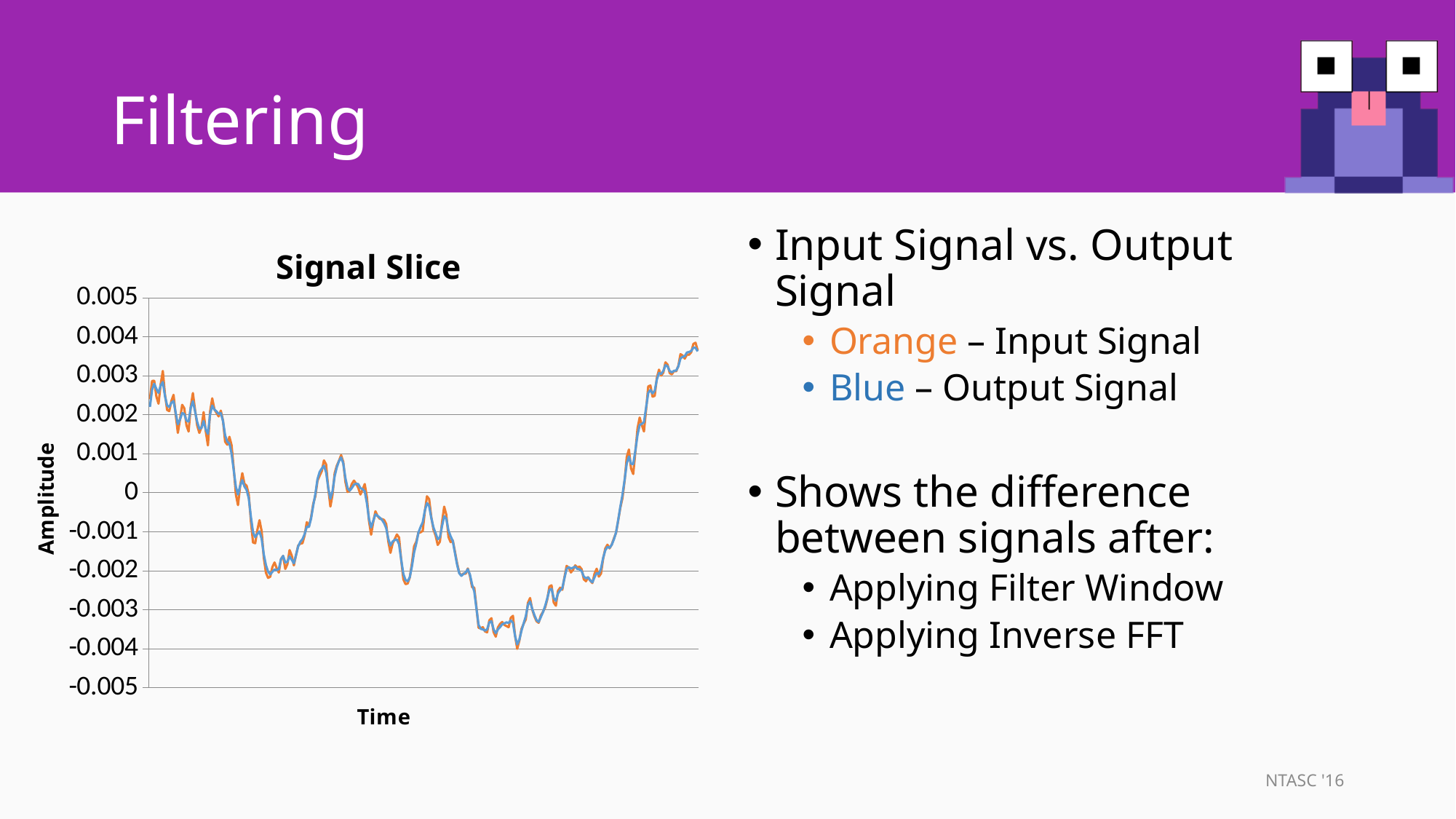
Is the lowest point reached by the signals in the chart greater or less than -0.003? less What is the highest value shown on the vertical axis of the chart? 0.005 Over the first third of the time axis, do the signals generally rise or fall? fall How many lines (series) are plotted in the Signal Slice chart? 2 Do the signals end at a higher or lower amplitude at the right edge of the chart than where they start at the left edge? higher What is the lowest value shown on the vertical axis of the chart? -0.005 Is the value of the signals at the start of the chart (left edge) greater or less than 0.002? greater What is the title of the chart? Signal Slice What is the label of the vertical axis of the chart? Amplitude What kind of chart is shown on the slide? line chart Is the highest point reached by the signals in the chart greater or less than 0.003? greater